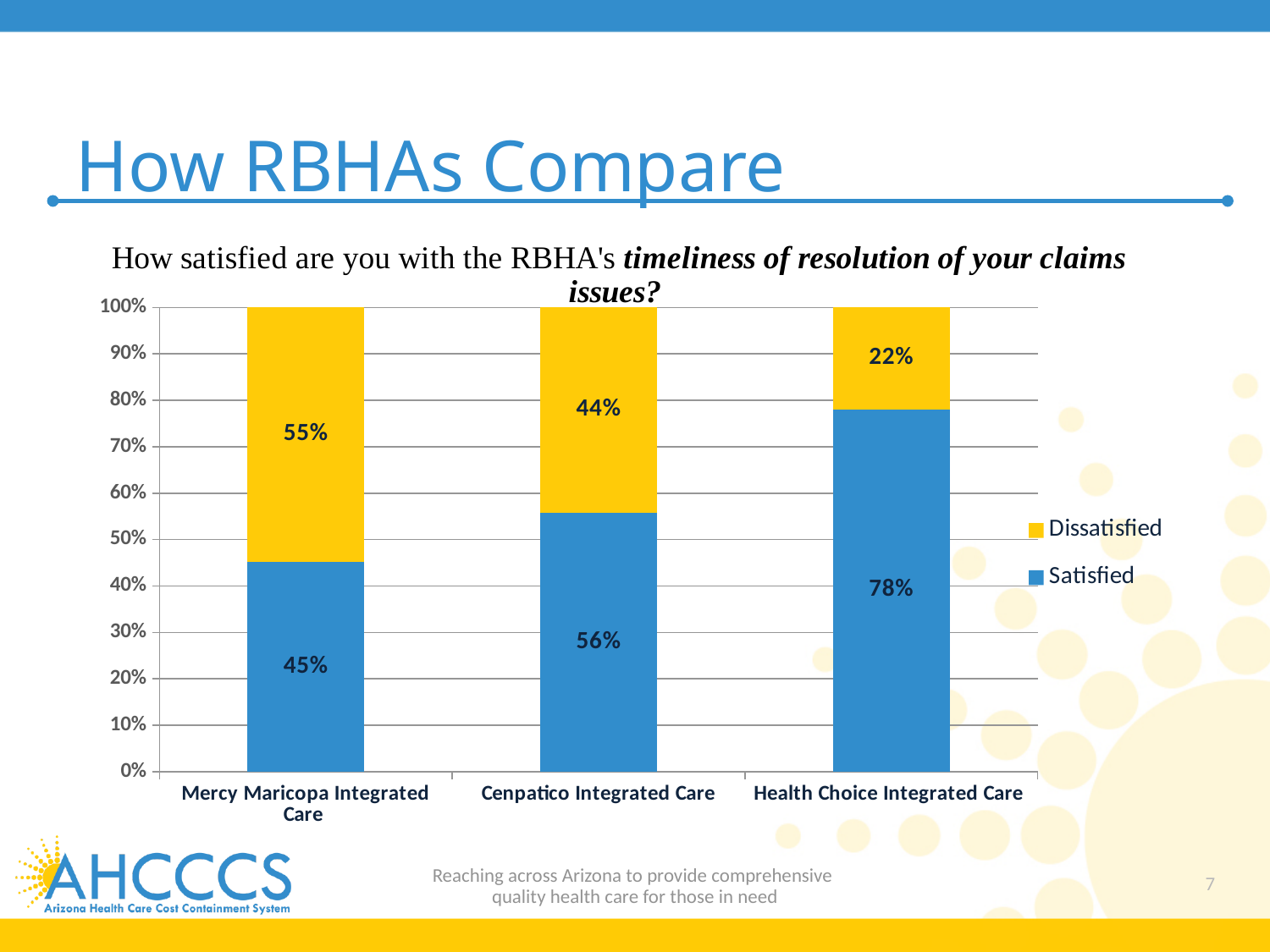
How many series does the legend list? 2 Is the Satisfied value for Cenpatico Integrated Care greater or less than 50%? greater Which RBHA has the lowest Satisfied percentage? Mercy Maricopa Integrated Care Which is larger: the Dissatisfied value for Cenpatico Integrated Care or the Dissatisfied value for Health Choice Integrated Care? Cenpatico Integrated Care Which colour represents the Dissatisfied series in the chart? Yellow How many RBHAs are shown on the x axis? 3 What percentage of respondents were Satisfied with Health Choice Integrated Care? 78% Which RBHA has the highest Satisfied percentage? Health Choice Integrated Care What percentage of respondents were Dissatisfied with Mercy Maricopa Integrated Care? 55% What kind of chart is shown on the slide? Stacked bar chart What is the difference between the Satisfied percentages for Health Choice Integrated Care and Mercy Maricopa Integrated Care? 33% What is the Satisfied value for Cenpatico Integrated Care? 56%